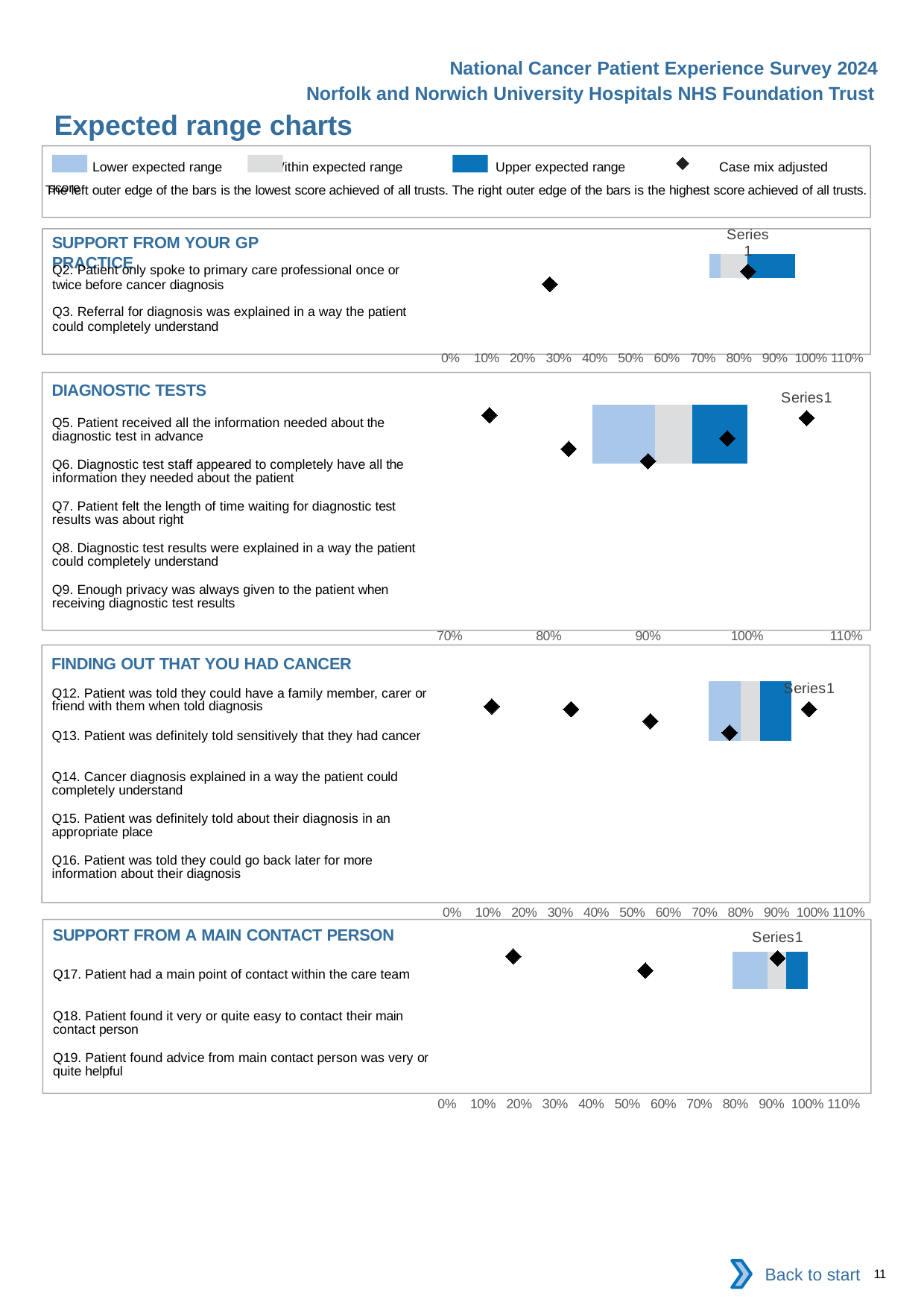
How many survey questions are listed in the "Finding out that you had cancer" chart? 5 How many entries does the legend at the top of the slide list? 4 What kind of chart is used in the "Diagnostic Tests" section? bar chart In the "Support from a main contact person" chart, is the leftmost diamond marker greater or less than 30%? less What is the lowest value shown on the x axis of the "Diagnostic Tests" chart? 70% How many survey questions are listed in the "Diagnostic Tests" chart? 5 Which legend entry is represented by a diamond marker? Case mix adjusted score How many diamond markers are plotted in the "Diagnostic Tests" chart? 5 In the "Diagnostic Tests" chart, is the leftmost diamond marker greater or less than 80%? less In the "Finding out that you had cancer" chart, is the rightmost diamond marker greater or less than 80%? greater